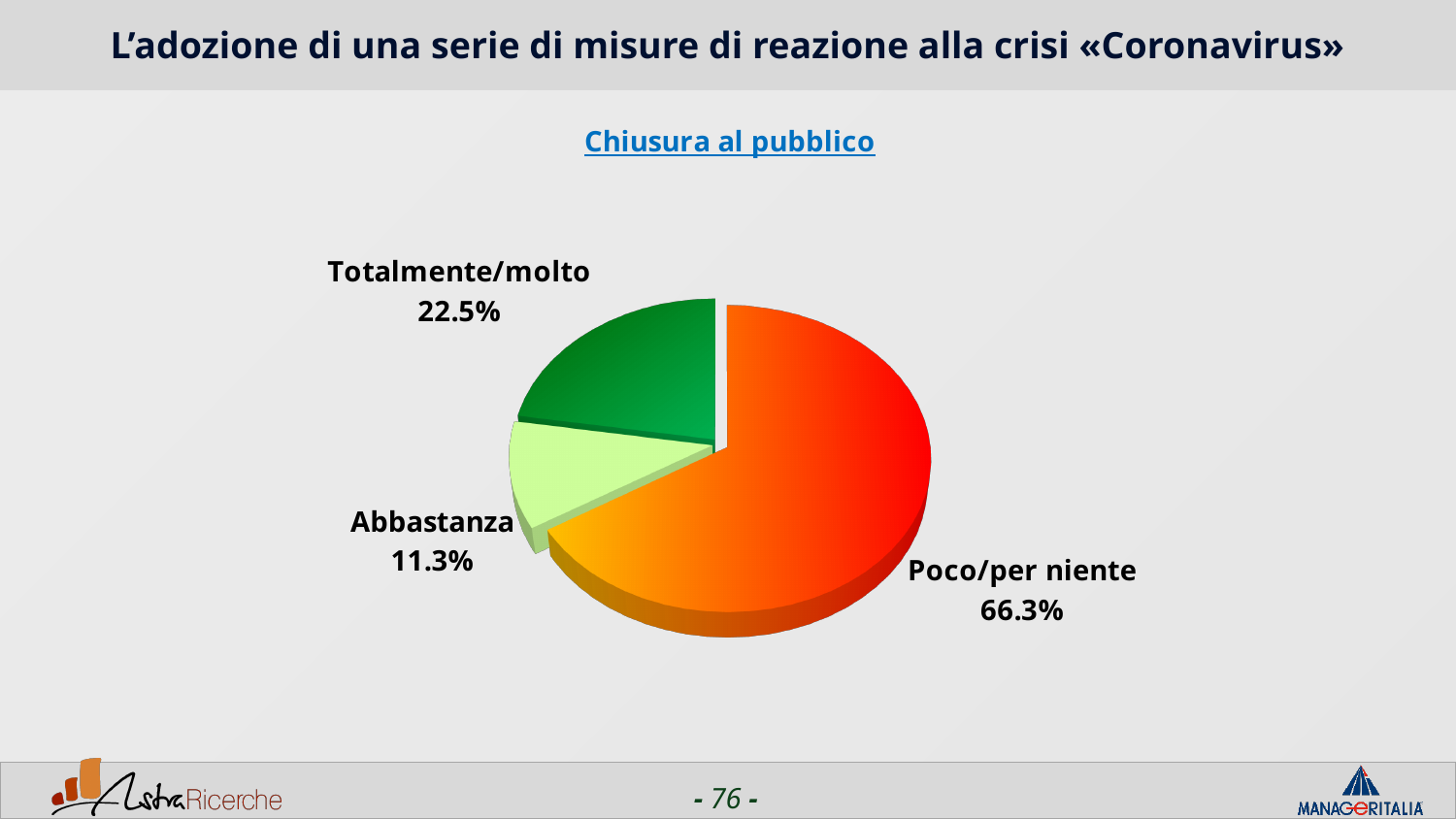
What is the value for Abbastanza? 11.3% What is the difference between the values for Poco/per niente and Totalmente/molto? 43.8% Which category has the smallest share of the pie? Abbastanza What is the difference between the values for Totalmente/molto and Abbastanza? 11.2% Which is larger, the value for Totalmente/molto or the value for Abbastanza? Totalmente/molto How many slices does the pie chart have? 3 What is the value for Totalmente/molto? 22.5% What is the value for Poco/per niente? 66.3% What colour is the Poco/per niente slice? red/orange What kind of chart is shown on the slide? pie chart Which category has the largest share of the pie? Poco/per niente What is the title of the chart? Chiusura al pubblico